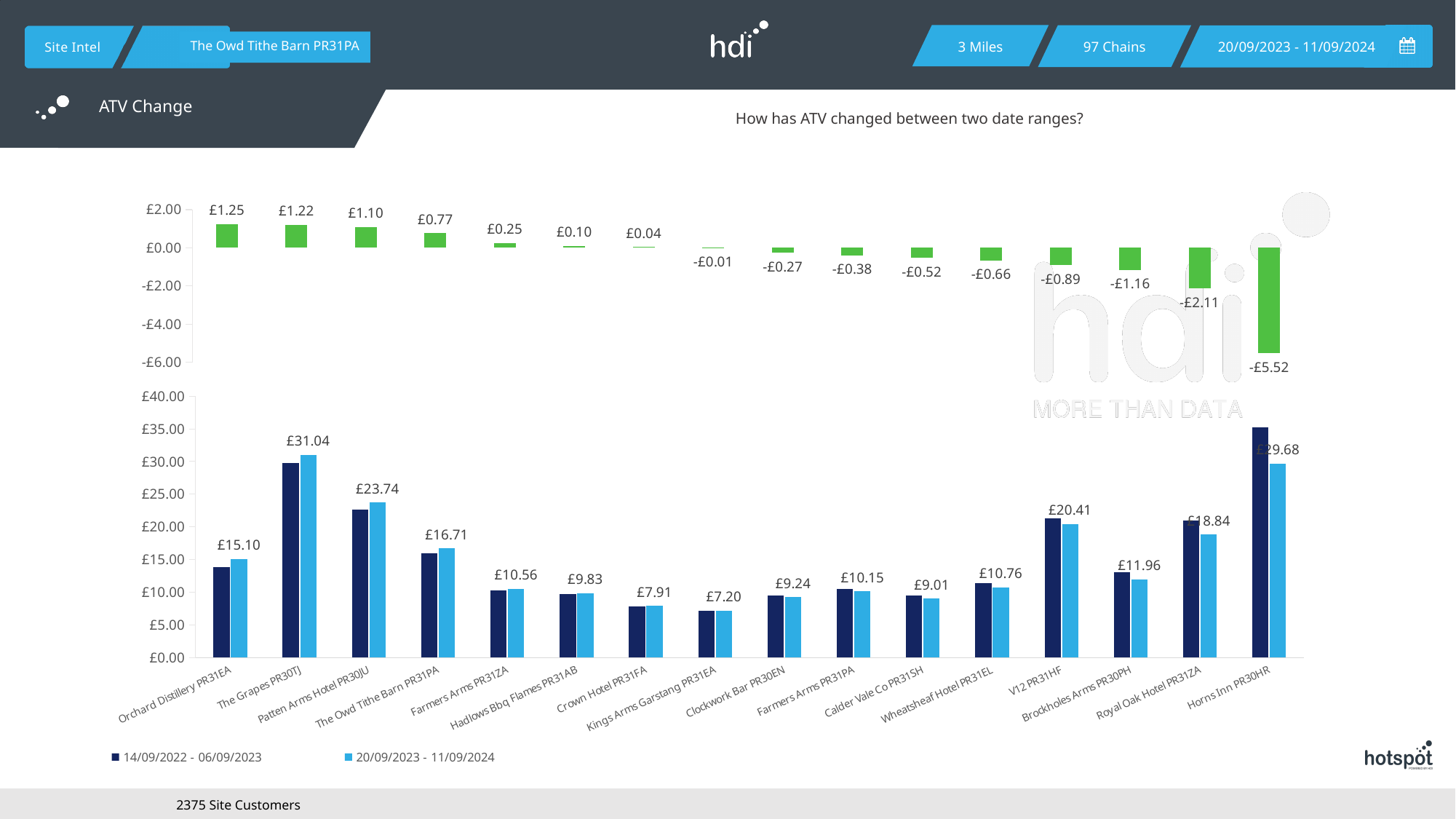
On the top chart, what is the ATV change for Brockholes Arms PR30PH? -£1.16 On the bottom chart, what is the value for Kings Arms Garstang PR31EA in the 20/09/2023 - 11/09/2024 period? £7.20 What kind of chart is the bottom chart? Bar chart On the top chart, what is the ATV change for Orchard Distillery PR31EA? £1.25 On the bottom chart, how many series does the legend list? 2 On the bottom chart, what is the value for The Grapes PR30TJ in the 20/09/2023 - 11/09/2024 period? £31.04 On the top chart, which site has the lowest ATV change? Horns Inn PR30HR On the top chart, what is the ATV change for Horns Inn PR30HR? -£5.52 On the bottom chart, which is larger for the 20/09/2023 - 11/09/2024 period: V12 PR31HF or Royal Oak Hotel PR31ZA? V12 PR31HF How many sites are shown on the bottom chart? 16 On the top chart, which site has the highest ATV change? Orchard Distillery PR31EA